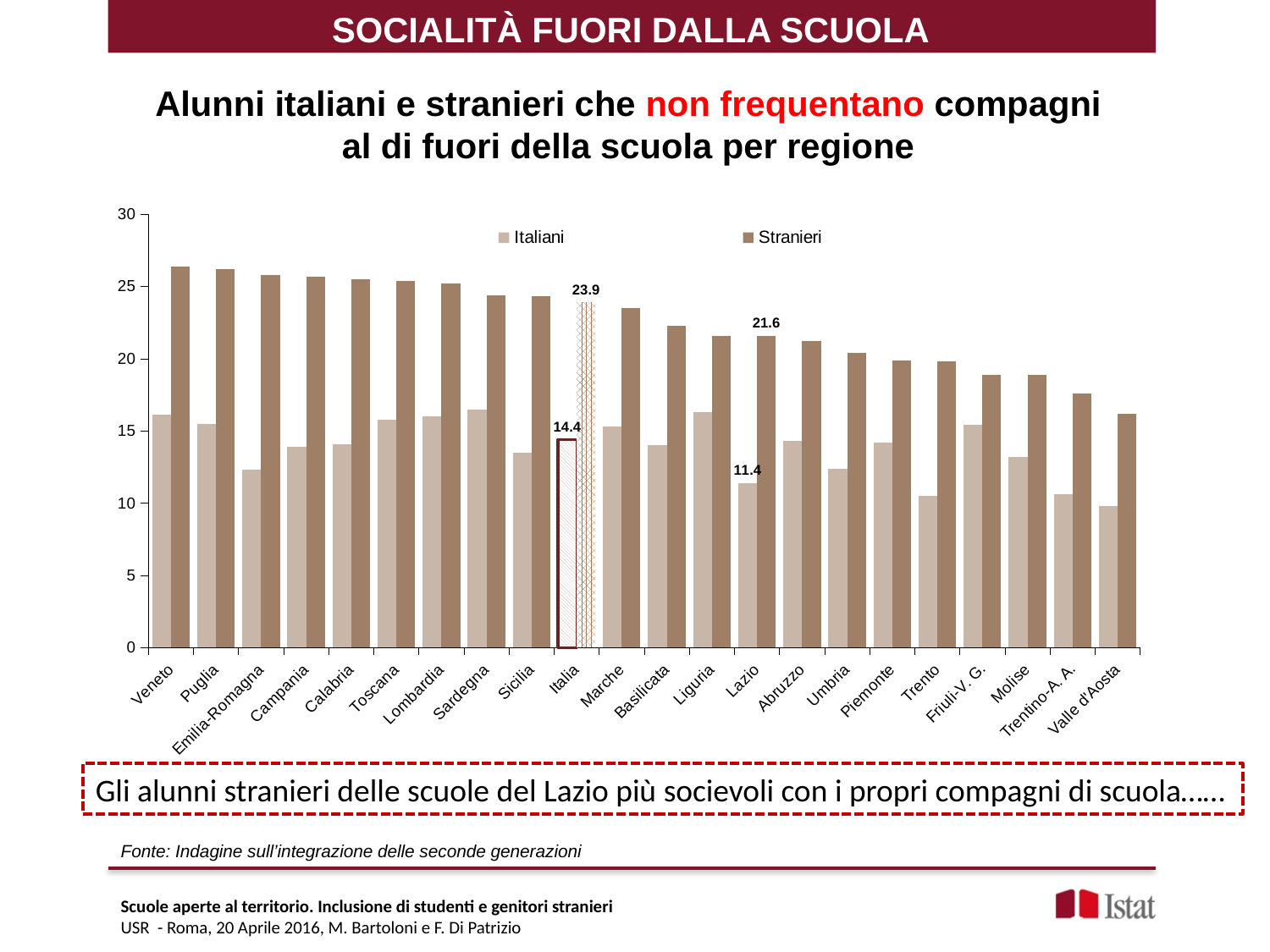
What kind of chart is shown on the slide? bar chart What is the value for Italiani in Italia? 14.4 What is the value for Italiani in Lazio? 11.4 What is the difference between the Stranieri and Italiani values for Italia? 9.5 What is the value for Stranieri in Lazio? 21.6 Do the Stranieri values generally rise or fall from left to right along the x axis? fall Is the Stranieri value for Veneto greater or less than 25? greater What is the value for Stranieri in Italia? 23.9 How many regions (categories) are shown on the x axis? 22 What is the difference between the Stranieri and Italiani values for Lazio? 10.2 Which has a higher Stranieri value, Italia or Lazio? Italia How many series does the legend list? 2